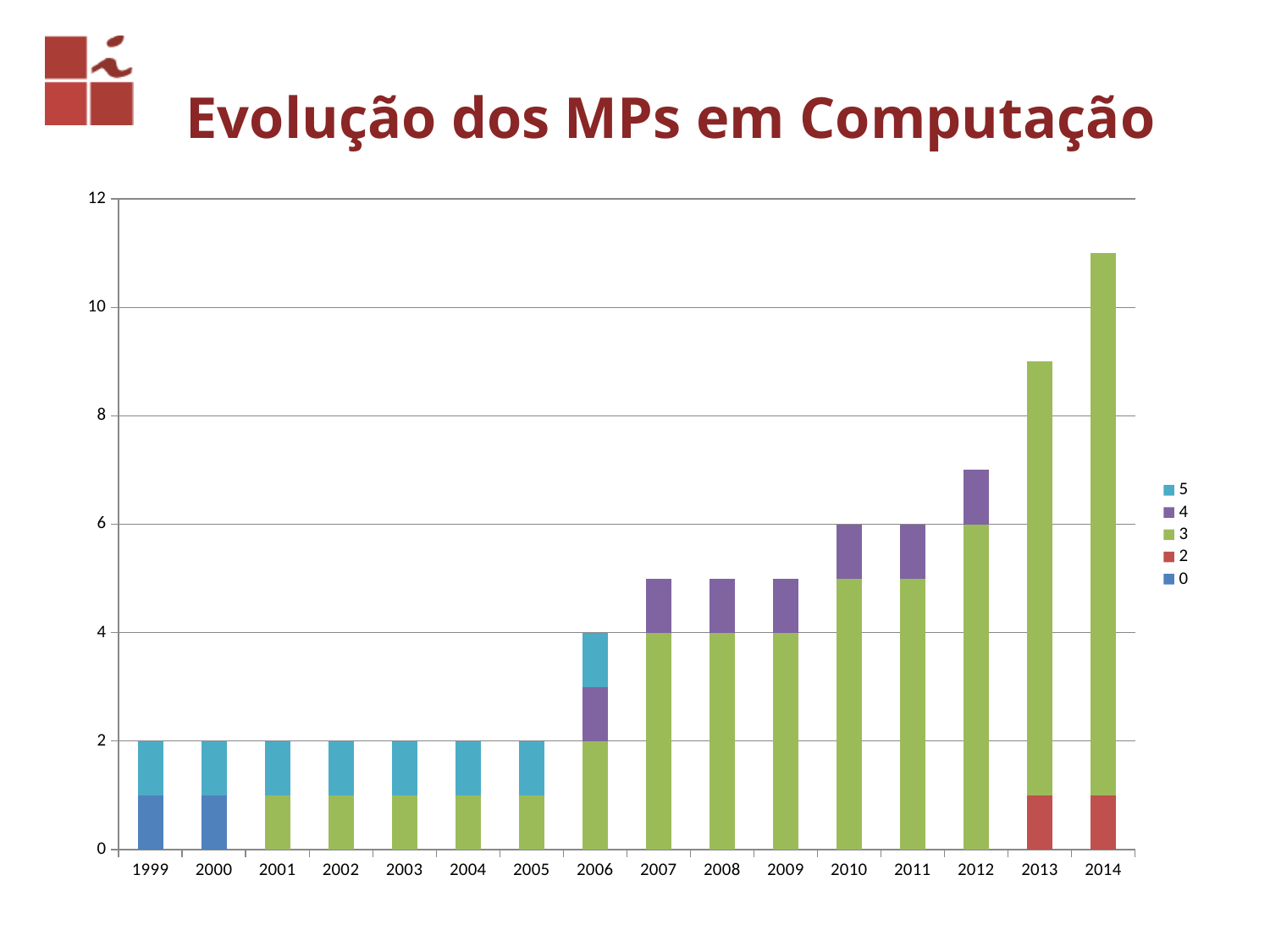
Do the bar totals generally rise or fall from 1999 to 2014? rise Is the total for 2014 greater or less than 10? greater What kind of chart is shown on the slide? stacked bar chart How many series does the legend list? 5 What is the total height of the stacked bar for 2010? 6 What is the value of series 3 in 2012? 6 What is the total height of the stacked bar for 1999? 2 How many years are shown along the x axis? 16 Which year has the tallest stacked bar? 2014 Is the total for 2013 greater or less than 8? greater Which year has the taller stacked bar, 2012 or 2013? 2013 What is the total height of the stacked bar for 2006? 4